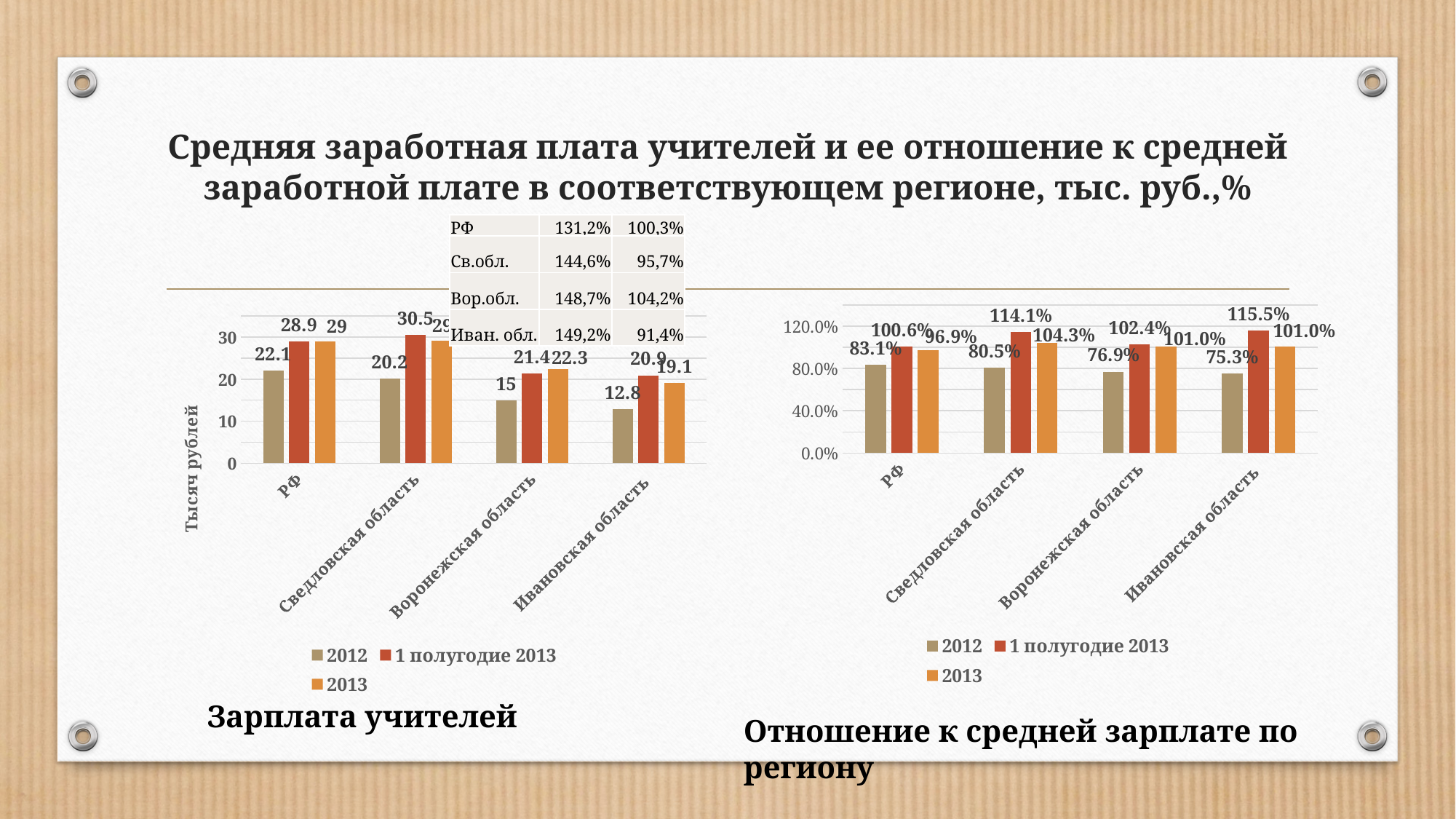
On the right chart (Отношение к средней зарплате по региону), what is the difference between the 2013 and 2012 values for Ивановская область? 25.7% What type of chart is the right chart (Отношение к средней зарплате по региону)? Bar chart On the left chart (Зарплата учителей), how many series does the legend list? 3 On the left chart (Зарплата учителей), what is the difference between the 2013 and 2012 values for Воронежская область? 7.3 On the left chart (Зарплата учителей), what is the value for Ивановская область for 1 полугодие 2013? 20.9 On the right chart (Отношение к средней зарплате по региону), what is the value for Свердловская область for 1 полугодие 2013? 114.1% On the left chart (Зарплата учителей), what is the value for РФ in 2012? 22.1 On the left chart (Зарплата учителей), what is the label of the vertical axis? Тысяч рублей On the right chart (Отношение к средней зарплате по региону), which region has the highest value for 1 полугодие 2013? Ивановская область On the right chart (Отношение к средней зарплате по региону), how many regions are shown on the x axis? 4 On the right chart (Отношение к средней зарплате по региону), which is larger for РФ: the 2012 value or the 2013 value? 2013 On the left chart (Зарплата учителей), which region has the lowest value in 2012? Ивановская область